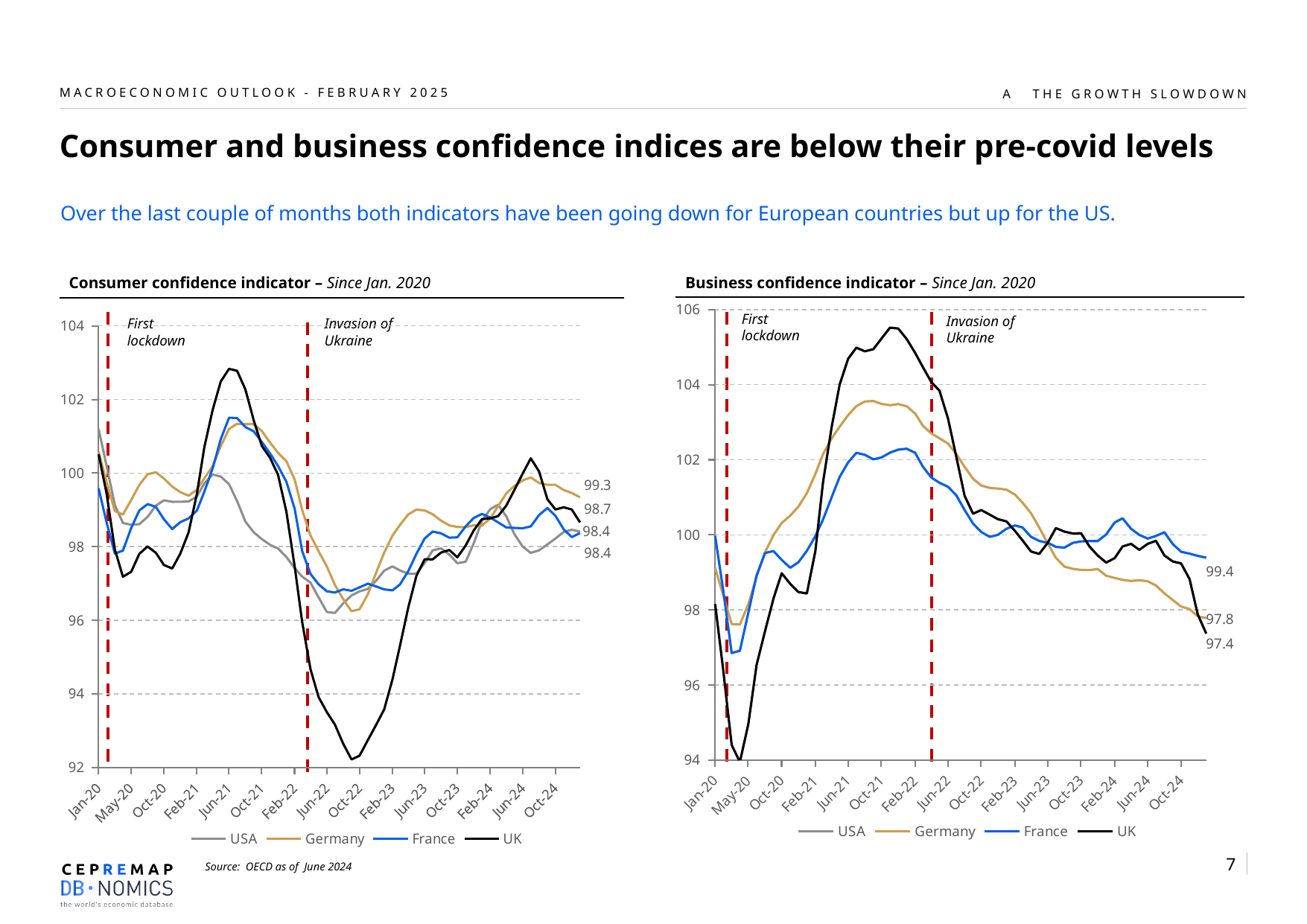
On the Consumer confidence indicator chart, is the lowest value reached by the UK line (around Oct-22) greater or less than 94? less On the Business confidence indicator chart, what is the difference between the final labelled values for France and the UK? 2.0 On the Business confidence indicator chart, what is the final labelled value for Germany? 97.8 On the Business confidence indicator chart, is the peak value of the UK line greater or less than 104? greater What two events do the red dashed vertical lines mark on the charts? First lockdown and Invasion of Ukraine On the Business confidence indicator chart, what is the final labelled value for France? 99.4 On the Consumer confidence indicator chart, what is the final labelled value for Germany? 99.3 On the Business confidence indicator chart, which series ends at the highest value? France On the Consumer confidence indicator chart, which series ends at the highest value? Germany On the Business confidence indicator chart, what is the final labelled value for the UK? 97.4 How many series does the legend of the Business confidence indicator chart list? 4 What type of chart is the Consumer confidence indicator chart? Line chart